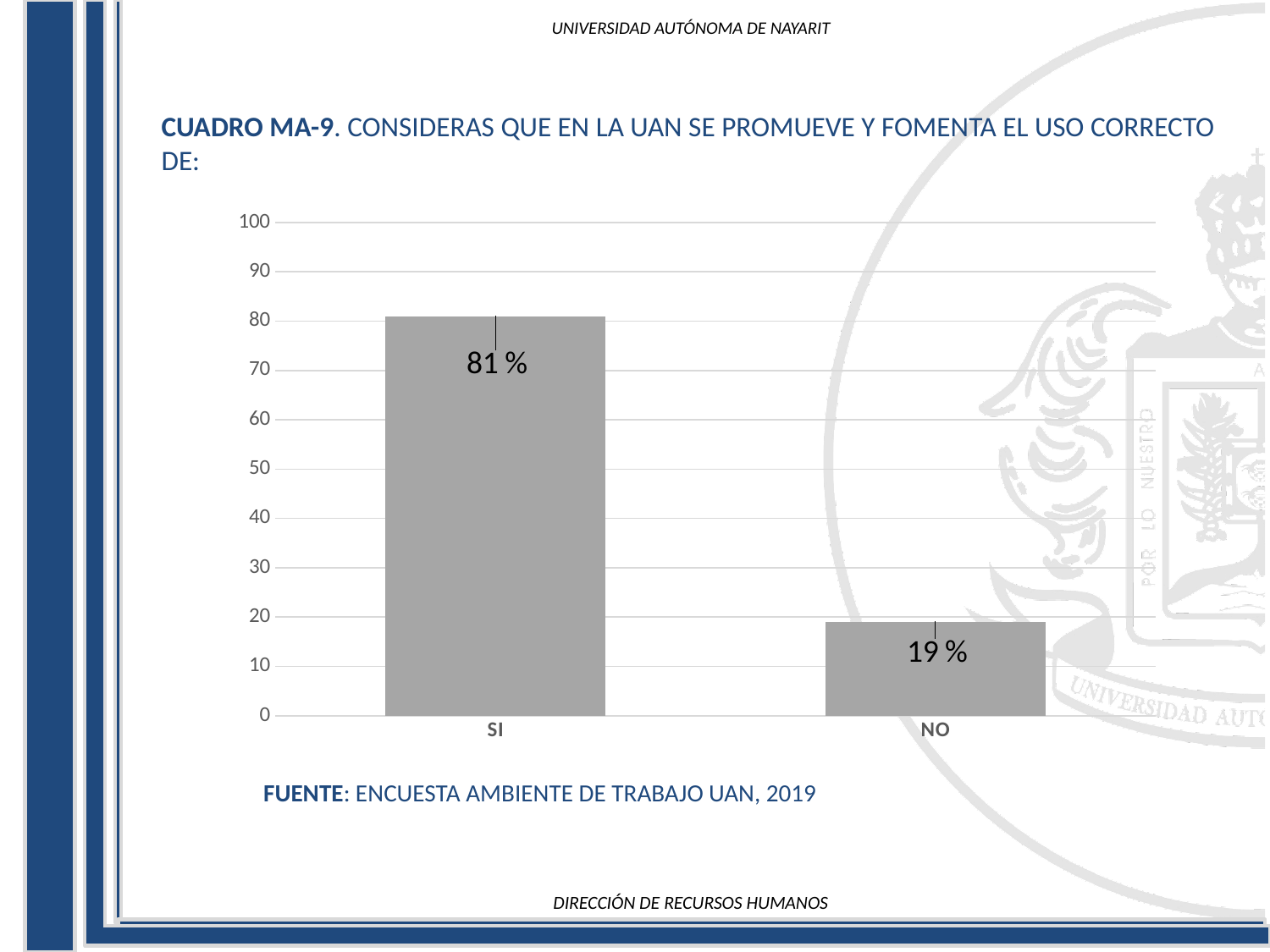
What kind of chart is shown on the slide? bar chart Is the value for NO greater or less than 30? less What is the value for NO? 19 % What is the total of the values for SI and NO? 100 % Which category has the highest value? SI Which category has the lowest value? NO What is the value for SI? 81 % What is the difference between the values for SI and NO? 62 % Is the value for SI greater or less than 50? greater Which is larger, the value for SI or the value for NO? SI How many categories are shown on the x axis? 2 What is the source cited below the chart? ENCUESTA AMBIENTE DE TRABAJO UAN, 2019